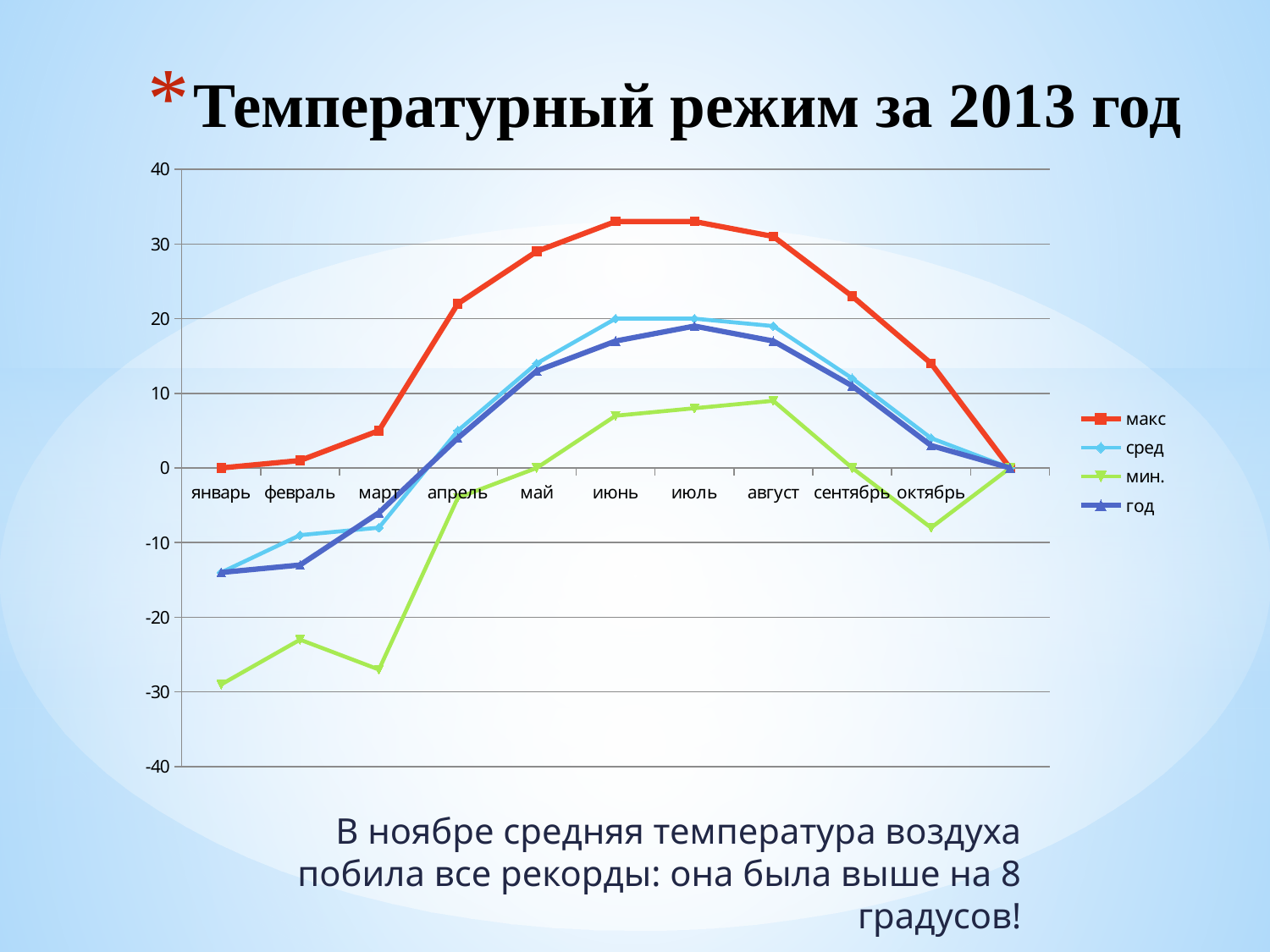
Is the value of the макс series for июль greater or less than 30? greater Which is larger in май: the макс series or the сред series? макс Does the макс series rise or fall from январь to июль? rise Is the value of the год series for январь greater or less than -10? less What kind of chart is shown on the slide? line chart Is the value of the мин. series for январь greater or less than -20? less Which series is drawn in red? макс What is the value of the макс series for январь? 0 What is the title of the slide's chart? Температурный режим за 2013 год What is the value of the мин. series for май? 0 How many series does the legend list? 4